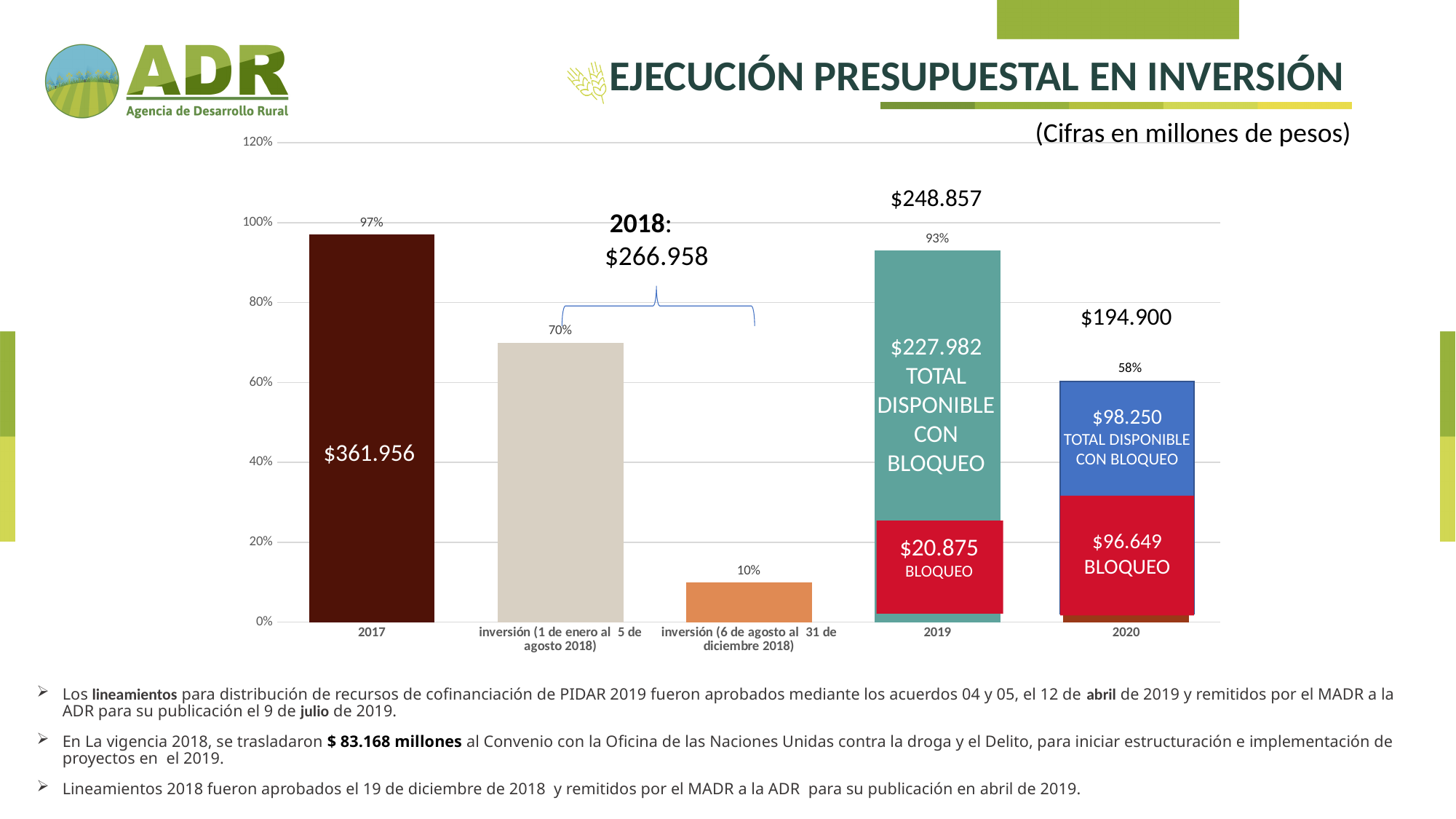
Which category has the lowest percentage? inversión (6 de agosto al 31 de diciembre 2018) How many bars are plotted on the chart? 5 Which category has the highest percentage? 2017 What percentage is shown above the bar for 2020? 58% What amount is labelled as TOTAL DISPONIBLE CON BLOQUEO in the 2019 bar? $227.982 What amount is labelled as BLOQUEO in the 2020 bar? $96.649 Which has a higher percentage, 2019 or 2020? 2019 What percentage is shown above the bar for 'inversión (6 de agosto al 31 de diciembre 2018)'? 10% What is the difference in percentage points between the 2017 bar (97%) and the 'inversión (1 de enero al 5 de agosto 2018)' bar (70%)? 27% What type of chart is shown on the slide? bar chart What percentage is shown above the bar for 2019? 93% What percentage is shown above the bar for 2017? 97%